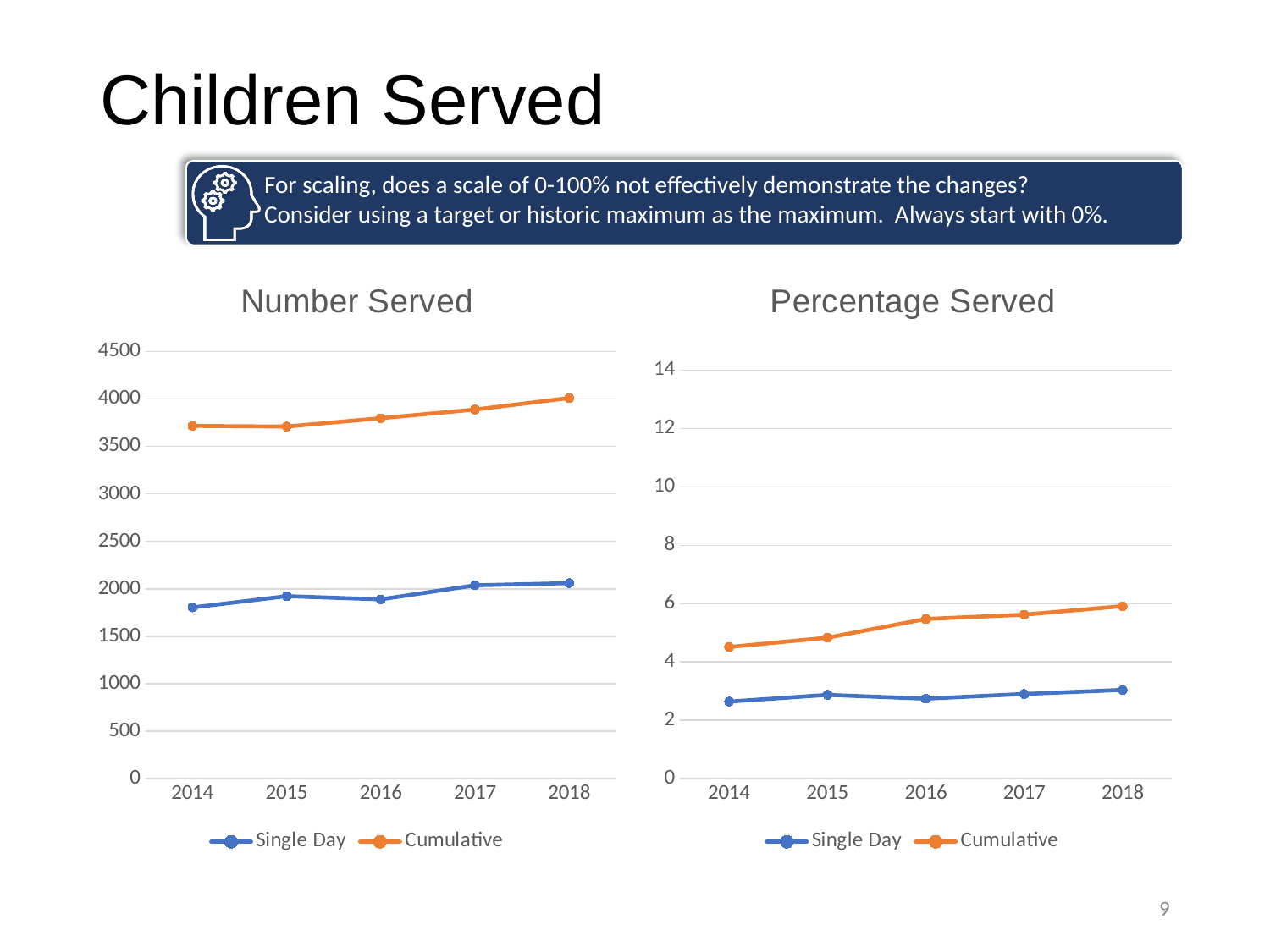
In the Percentage Served chart, does the Cumulative series rise or fall from 2014 to 2018? rise How many series does the legend of the Percentage Served chart list? 2 How many years are plotted on the x axis of the Number Served chart? 5 In the Number Served chart, is the Single Day value for 2014 greater or less than 2000? less What kind of chart is the Number Served chart? line chart In the Number Served chart, in which year is the Cumulative series highest? 2018 In the Number Served chart, is the Cumulative value for 2018 greater or less than 3500? greater In the Percentage Served chart, is the Single Day value for 2014 greater or less than 4? less In the Number Served chart, which series has the larger value in 2018, Single Day or Cumulative? Cumulative In the Percentage Served chart, in which year is the Cumulative series lowest? 2014 What colour is the Cumulative line in the Number Served chart? orange